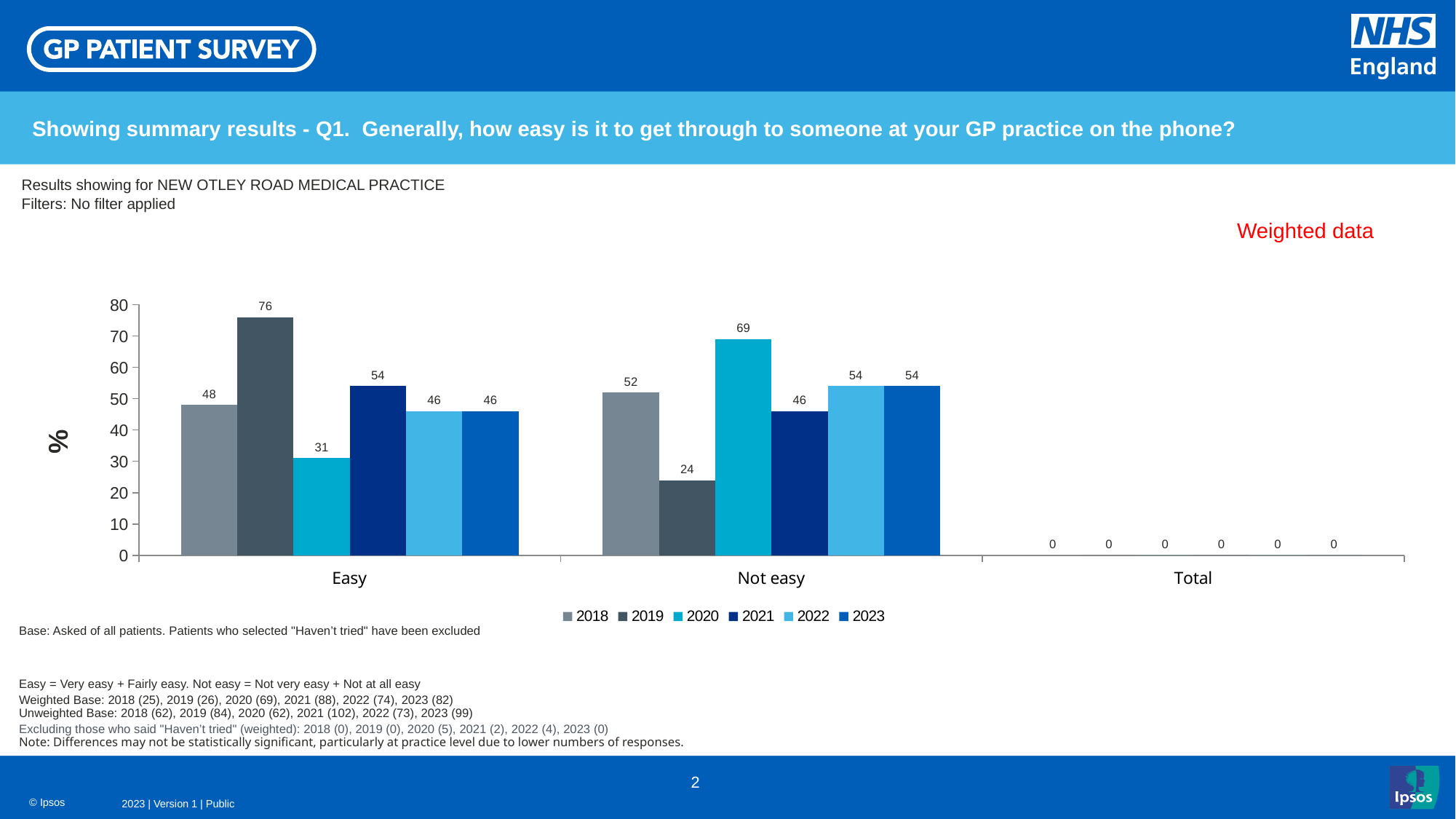
Which year has the highest value in the Easy category? 2019 How many categories are shown on the x axis? 3 What is the value for 2023 in the Easy category? 46 Which year has the lowest value in the Not easy category? 2019 What is the value for 2019 in the Easy category? 76 What is the value for 2020 in the Not easy category? 69 What label is shown on the y axis? % Which is larger: the 2018 value for Easy or the 2018 value for Not easy? Not easy What is the difference between the 2019 and 2020 values in the Easy category? 45 What is the value for 2021 in the Not easy category? 46 How many series does the legend list? 6 What kind of chart is shown on the slide? Bar chart